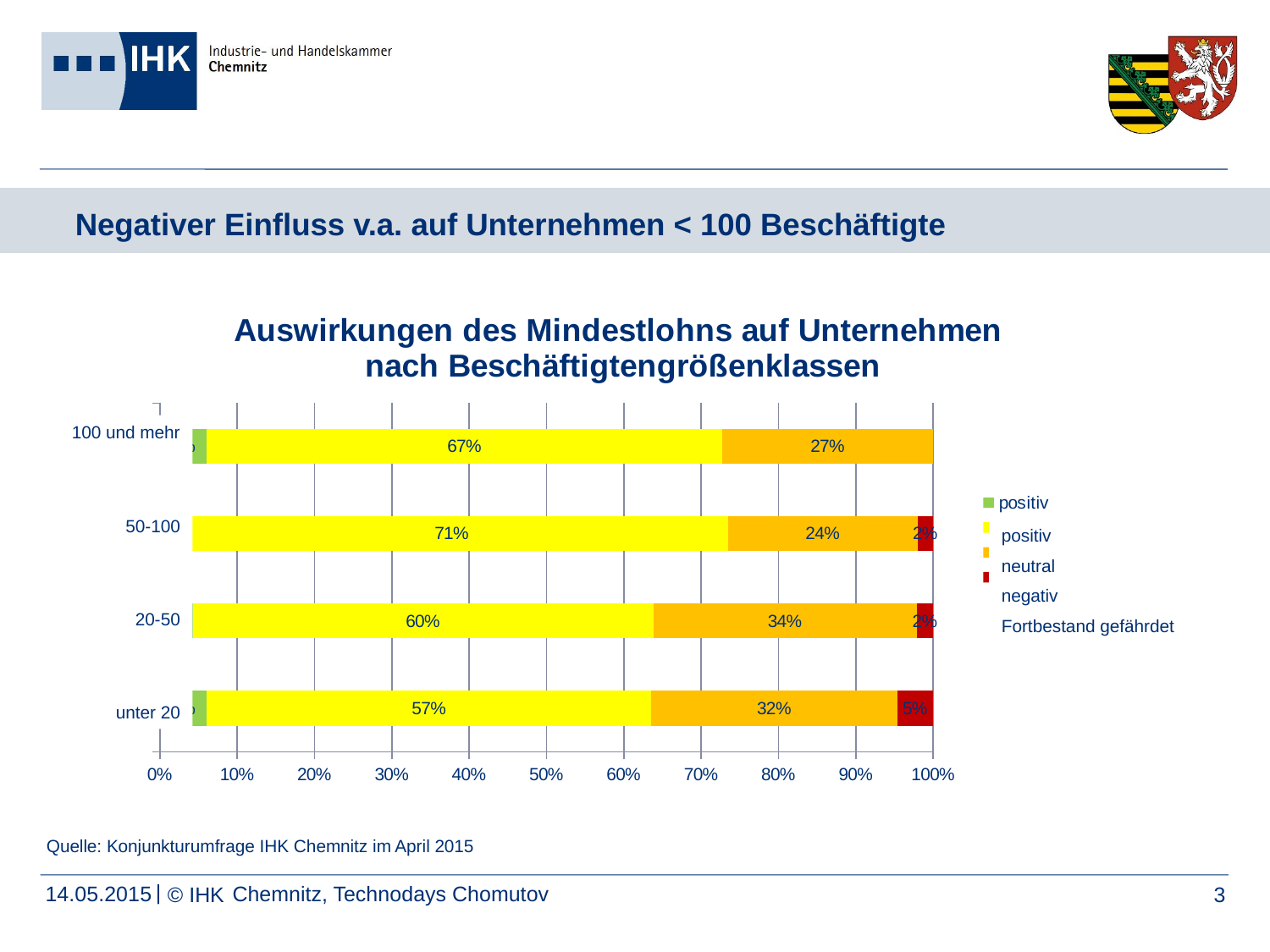
What is the value of the yellow segment for the "50-100" category? 71% Which category has the smallest yellow segment? unter 20 Which category has the largest yellow segment? 50-100 Which category has the largest orange "neutral" segment? 20-50 What is the title of the chart? Auswirkungen des Mindestlohns auf Unternehmen nach Beschäftigtengrößenklassen How many employee size categories are shown on the chart? 4 What is the value of the orange "neutral" segment for the "20-50" category? 34% Is the orange "neutral" segment larger for "20-50" or for "100 und mehr"? 20-50 What is the value of the orange "neutral" segment for the "100 und mehr" category? 27% What is the value of the dark red segment for the "unter 20" category? 5% What is the difference between the yellow segment values for "50-100" and "unter 20"? 14 percentage points What type of chart is shown on the slide? Stacked bar chart